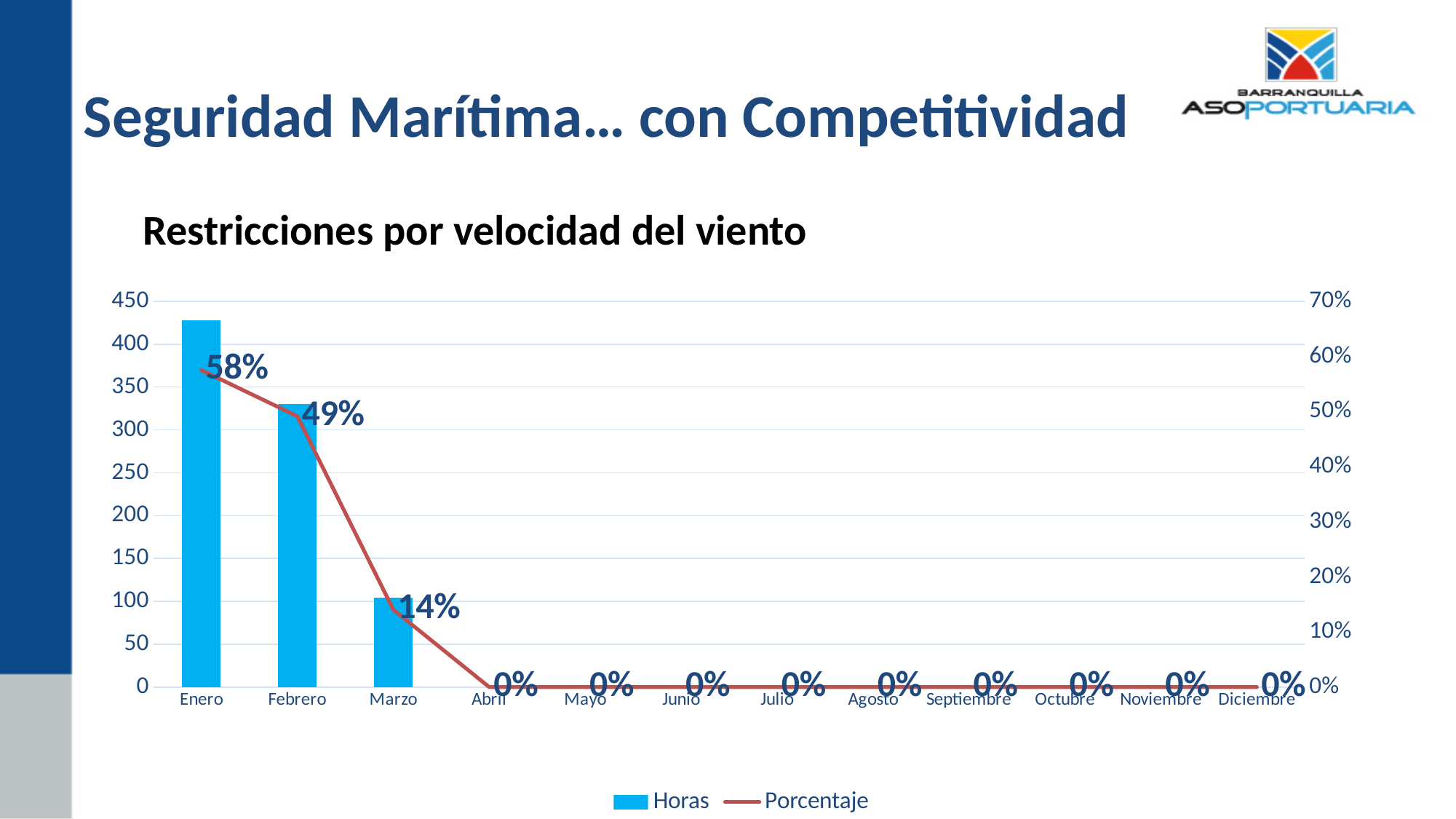
What is the Porcentaje value for Febrero? 49% Which month has a larger Horas value, Enero or Marzo? Enero Is the Horas value for Enero greater or less than 400? greater Is the Horas value for Febrero greater or less than 300? greater Which month has the highest Porcentaje value? Enero How many series does the legend list? 2 Is the Horas value for Marzo greater or less than 150? less What is the Porcentaje value for Enero? 58% What is the Porcentaje value for Julio? 0% What is the difference between the Porcentaje values for Febrero and Marzo? 35% What is the difference between the Porcentaje values for Enero and Febrero? 9% What is the Porcentaje value for Marzo? 14%